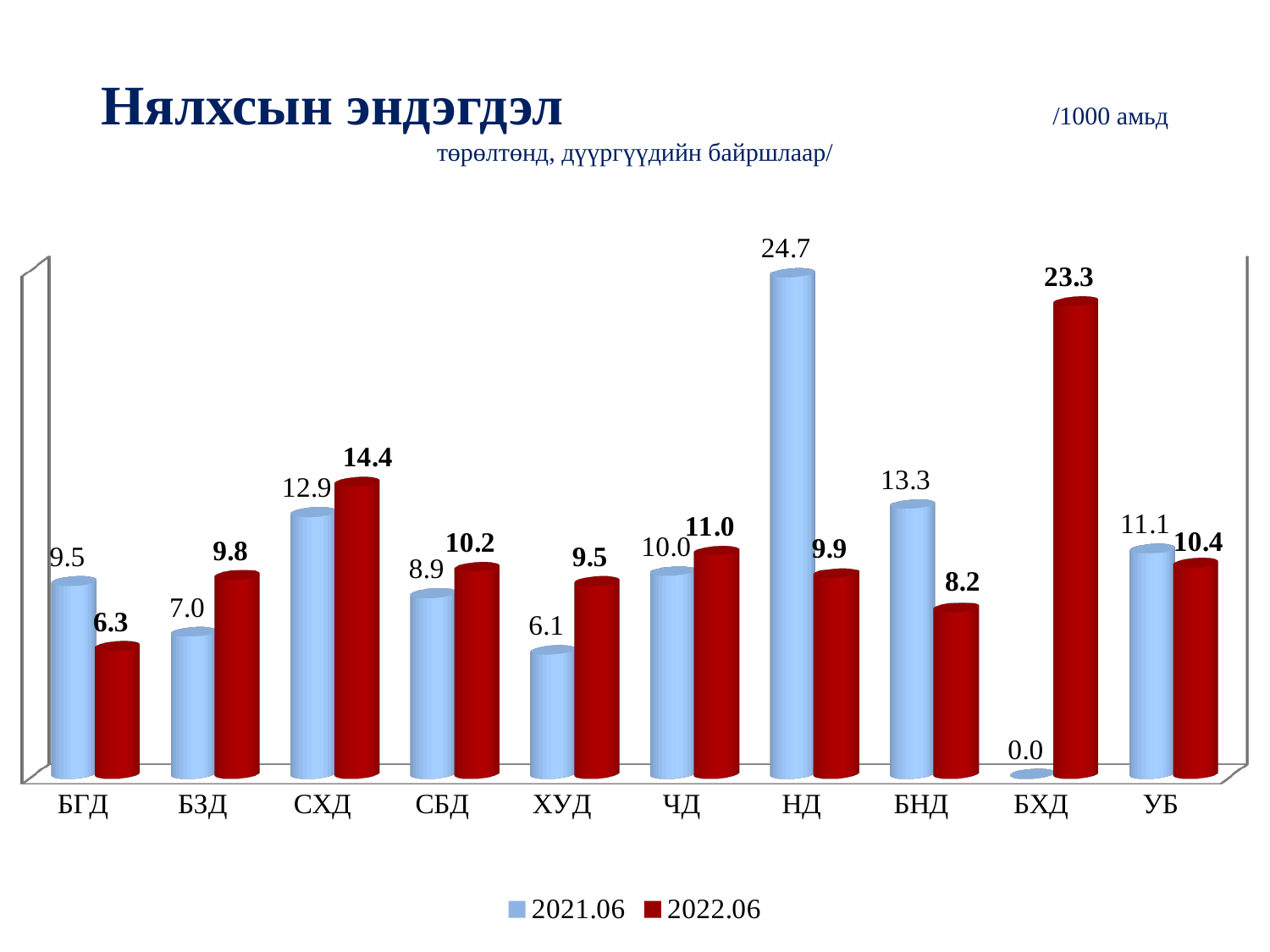
What is the 2021.06 value for НД? 24.7 Which is larger for БНД: the 2021.06 value or the 2022.06 value? 2021.06 How many series does the legend list? 2 Which series is shown in dark red in the legend? 2022.06 What is the 2021.06 value for ХУД? 6.1 What is the 2022.06 value for БХД? 23.3 Which category has the highest 2022.06 value? БХД What is the difference between the 2021.06 and 2022.06 values for НД? 14.8 What is the 2022.06 value for СХД? 14.4 Which category has the lowest 2021.06 value? БХД What kind of chart is shown on the slide? Bar chart How many categories are shown on the x axis? 10